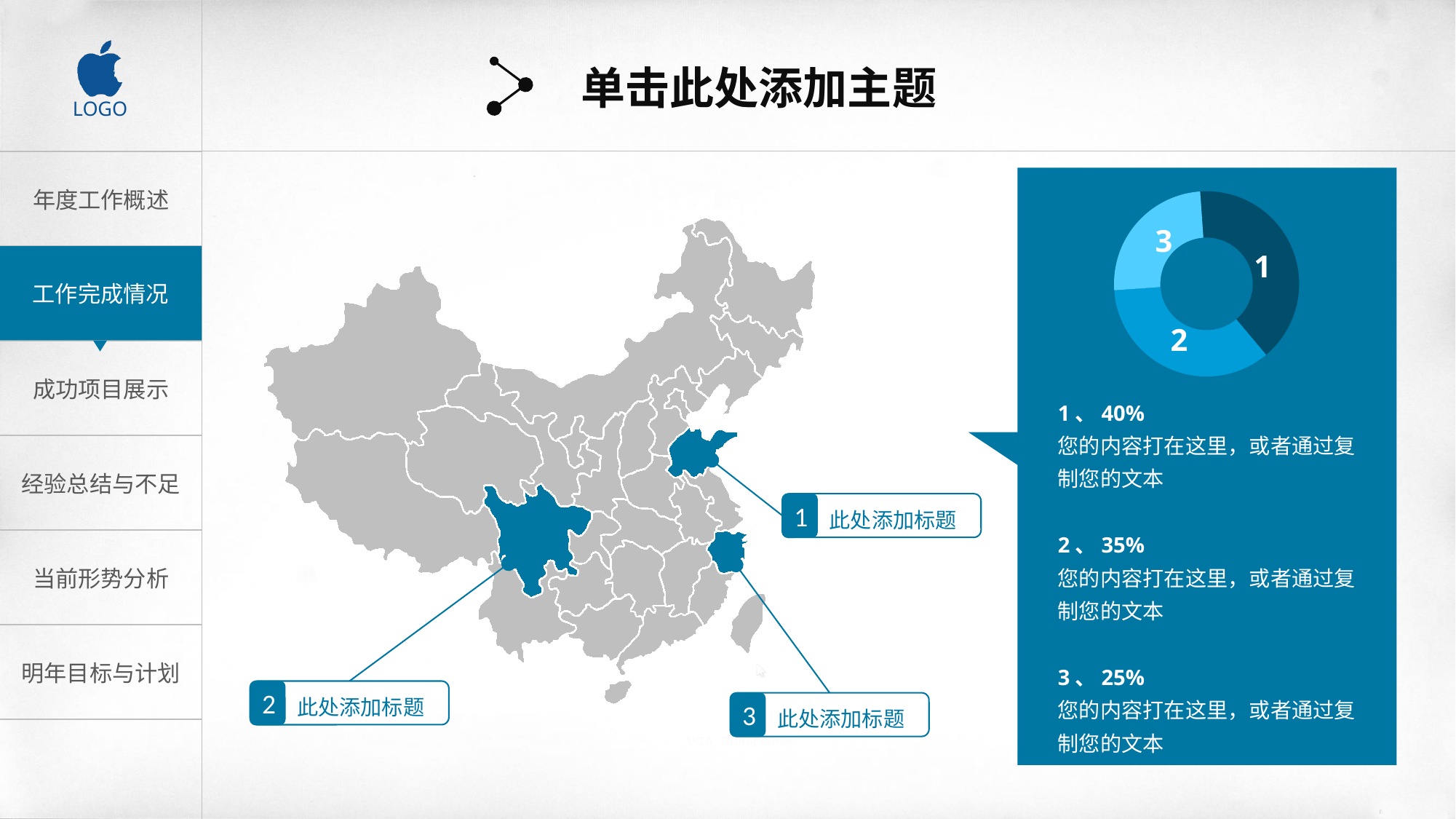
What share does segment 3 of the donut chart represent? 25% What is the difference between the shares of segment 2 and segment 3 in the donut chart? 10% What is the combined share of segments 2 and 3 in the donut chart? 60% Which segment of the donut chart is the largest? 1 Which segment of the donut chart is the smallest? 3 How many segments does the donut chart have? 3 What share does segment 1 of the donut chart represent? 40% What kind of chart is shown on the right side of the slide? donut chart Which segment of the donut chart is drawn in the darkest colour? 1 In the donut chart, which is larger: segment 1 or segment 2? segment 1 What share does segment 2 of the donut chart represent? 35% What is the difference between the shares of segment 1 and segment 3 in the donut chart? 15%